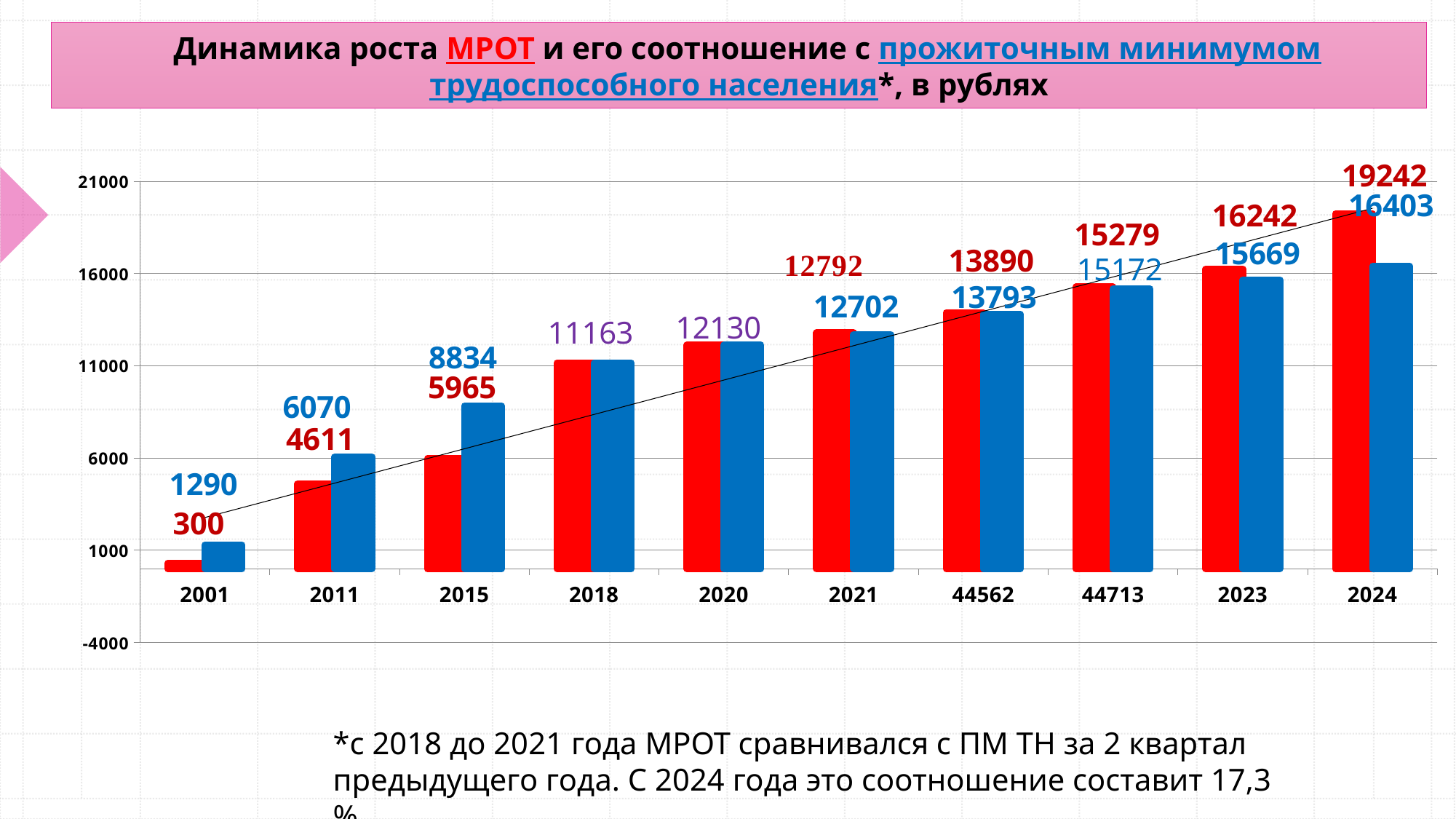
Is the value of the blue bar for 2015 greater or less than 11000? less Do the red bars rise or fall from left to right along the x axis? rise What is the value of the red bar for 2024? 19242 How many categories are shown on the x axis? 10 What is the difference between the red bar and the blue bar for 2024? 2839 What is the value of the blue bar for 2023? 15669 What is the value of the blue bar for 2001? 1290 What value is labelled for 2018? 11163 For 2011, which bar is larger, the red one or the blue one? the blue one What kind of chart is shown on the slide? bar chart Which category has the lowest red bar? 2001 Which category has the highest red bar? 2024